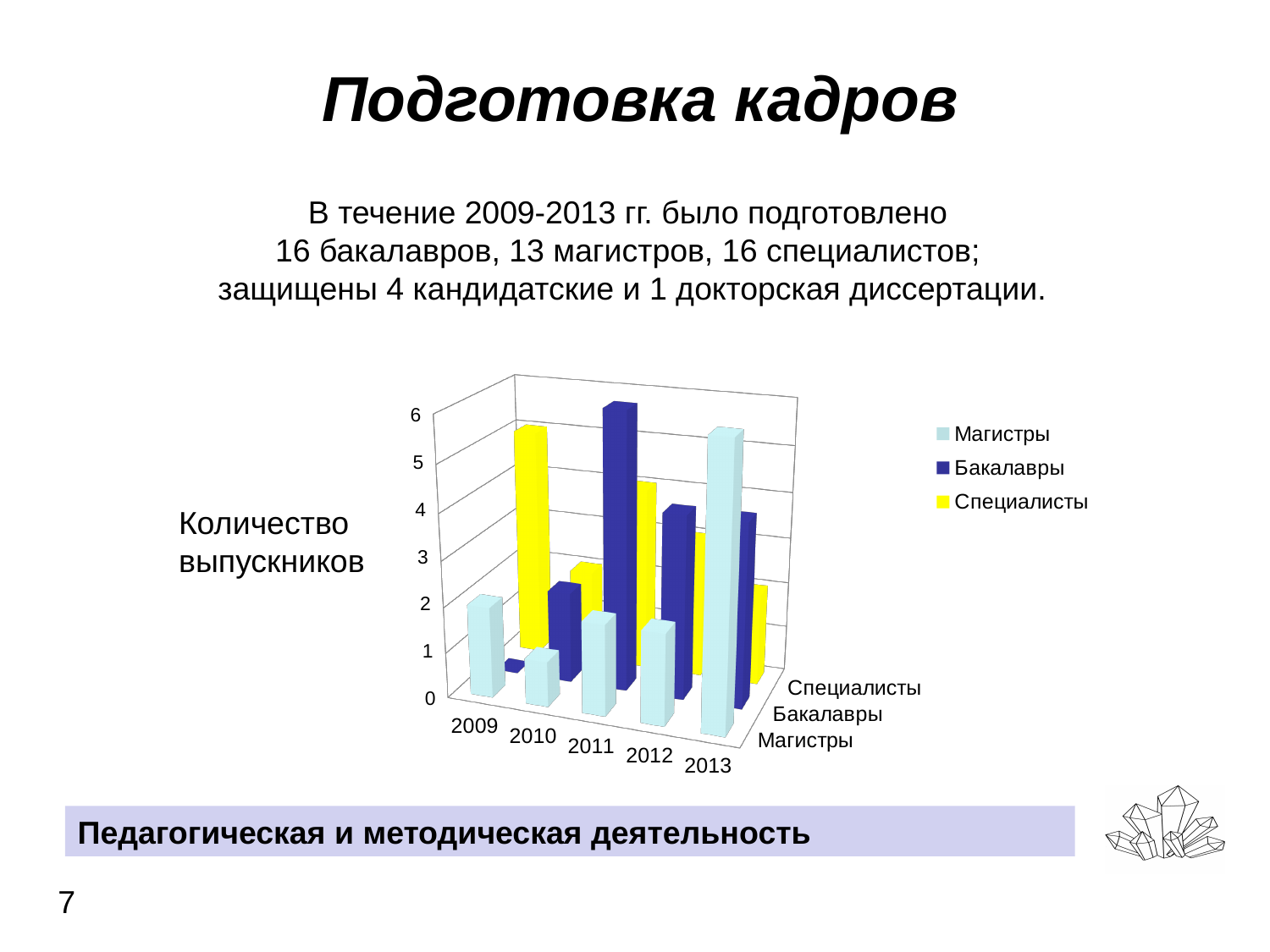
How many years are shown along the x axis of the chart? 5 In which year is the value for Магистры highest? 2013 What kind of chart is shown on the slide? bar chart Which is larger for Магистры: the value in 2013 or the value in 2010? 2013 What is the label on the vertical axis of the chart? Количество выпускников In which year is the value for Бакалавры lowest? 2009 Is the value for Магистры in 2013 greater or less than 4? greater Which series are listed in the chart legend? Магистры, Бакалавры, Специалисты Is the value for Магистры in 2010 greater or less than 2? less In which year is the value for Специалисты highest? 2009 In which year is the value for Бакалавры highest? 2011 How many series does the chart legend list? 3